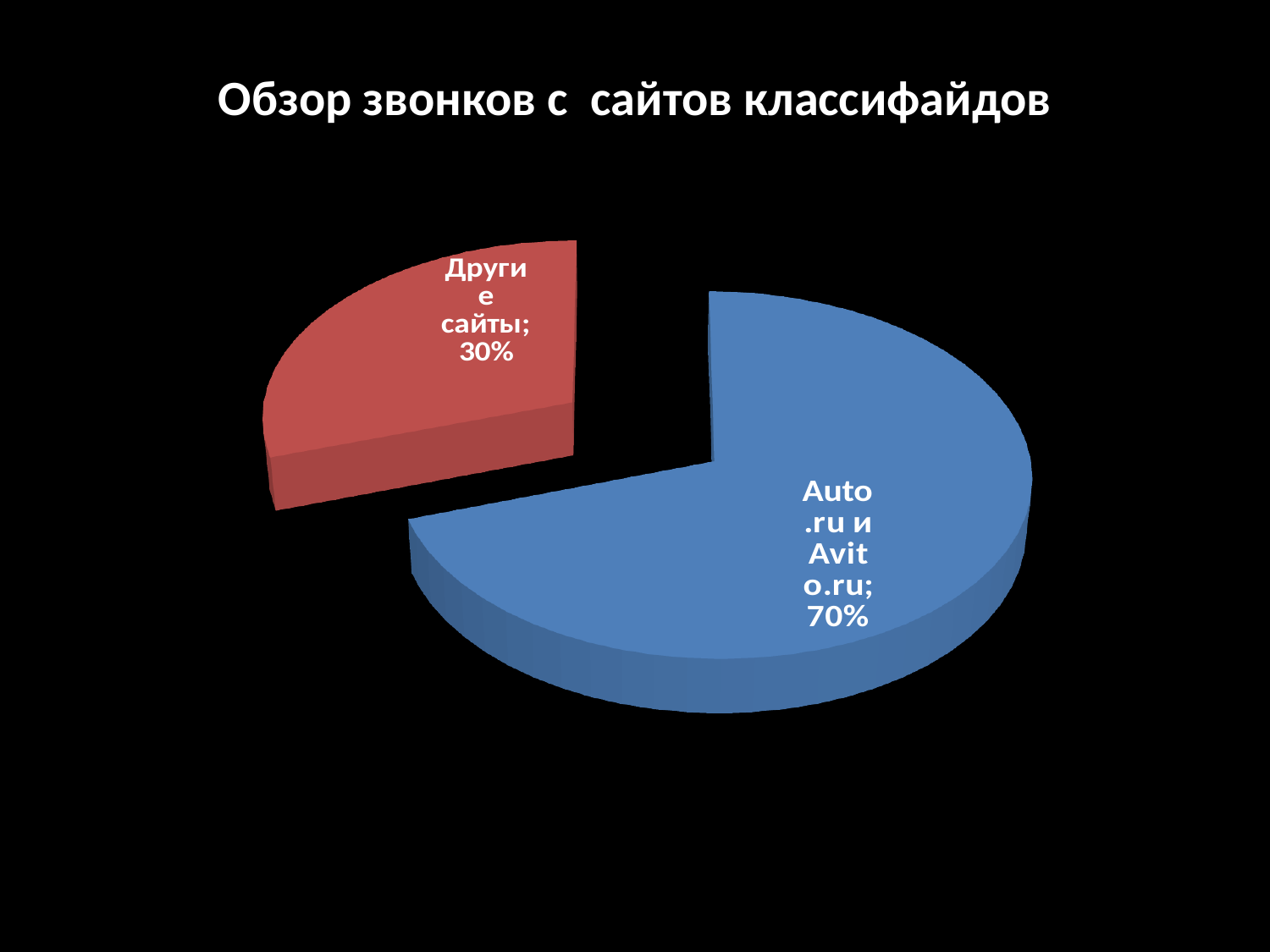
How many slices does the pie chart have? 2 What is the total of the two slices shown in the pie chart? 100% What share of the pie does the slice for Auto.ru и Avito.ru represent? 70% Which slice is the largest in the pie chart? Auto.ru и Avito.ru What is the title of the slide? Обзор звонков с сайтов классифайдов Is the share for Другие сайты greater or less than 50%? less Which is larger: the share for Auto.ru и Avito.ru or the share for Другие сайты? Auto.ru и Avito.ru Which slice is the smallest in the pie chart? Другие сайты What kind of chart is shown on the slide? Pie chart What is the difference in percentage points between the Auto.ru и Avito.ru slice and the Другие сайты slice? 40% What share of the pie does the slice for Другие сайты represent? 30% What colour is the slice for Другие сайты? Red